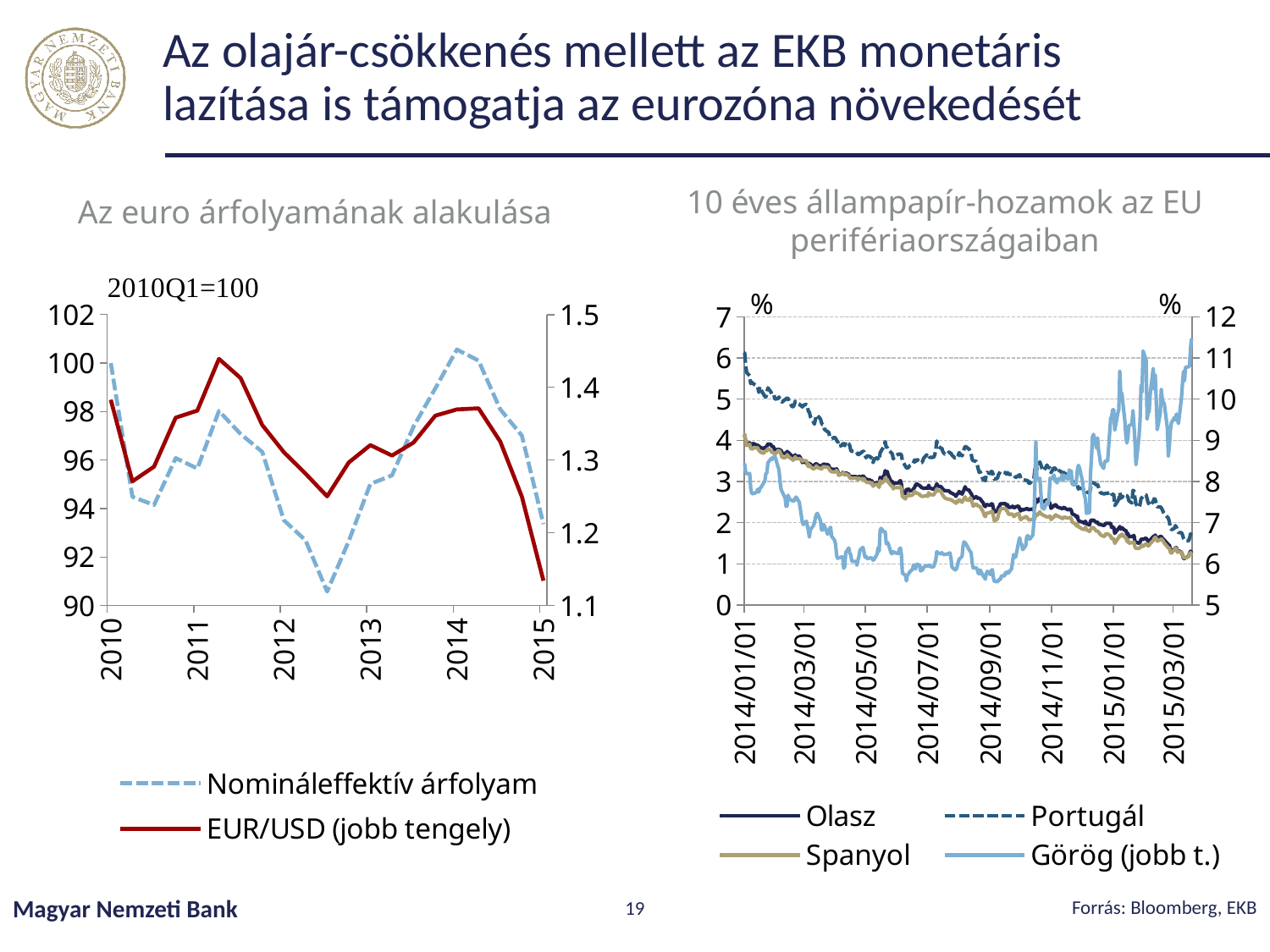
What kind of chart is the left chart, 'Az euro árfolyamának alakulása'? line chart In the left chart, does the EUR/USD series rise or fall between 2014 and 2015? fall In the left chart, is the Nomináleffektív árfolyam value at the start of 2010 greater or less than 98? greater In the right chart, is the Portugál value at 2014/01/01 greater or less than 5? greater In the right chart, which is higher at 2014/01/01, Portugál or Spanyol? Portugál In the right chart, is the Spanyol value at the end of the series (2015/03) greater or less than 2? less In the right chart, does the Olasz series rise or fall over the period shown? fall How many series does the legend of the right chart, '10 éves állampapír-hozamok az EU perifériaországaiban', list? 4 In the right chart, which series is plotted on the right axis according to the legend? Görög (jobb t.) How many series does the legend of the left chart, 'Az euro árfolyamának alakulása', list? 2